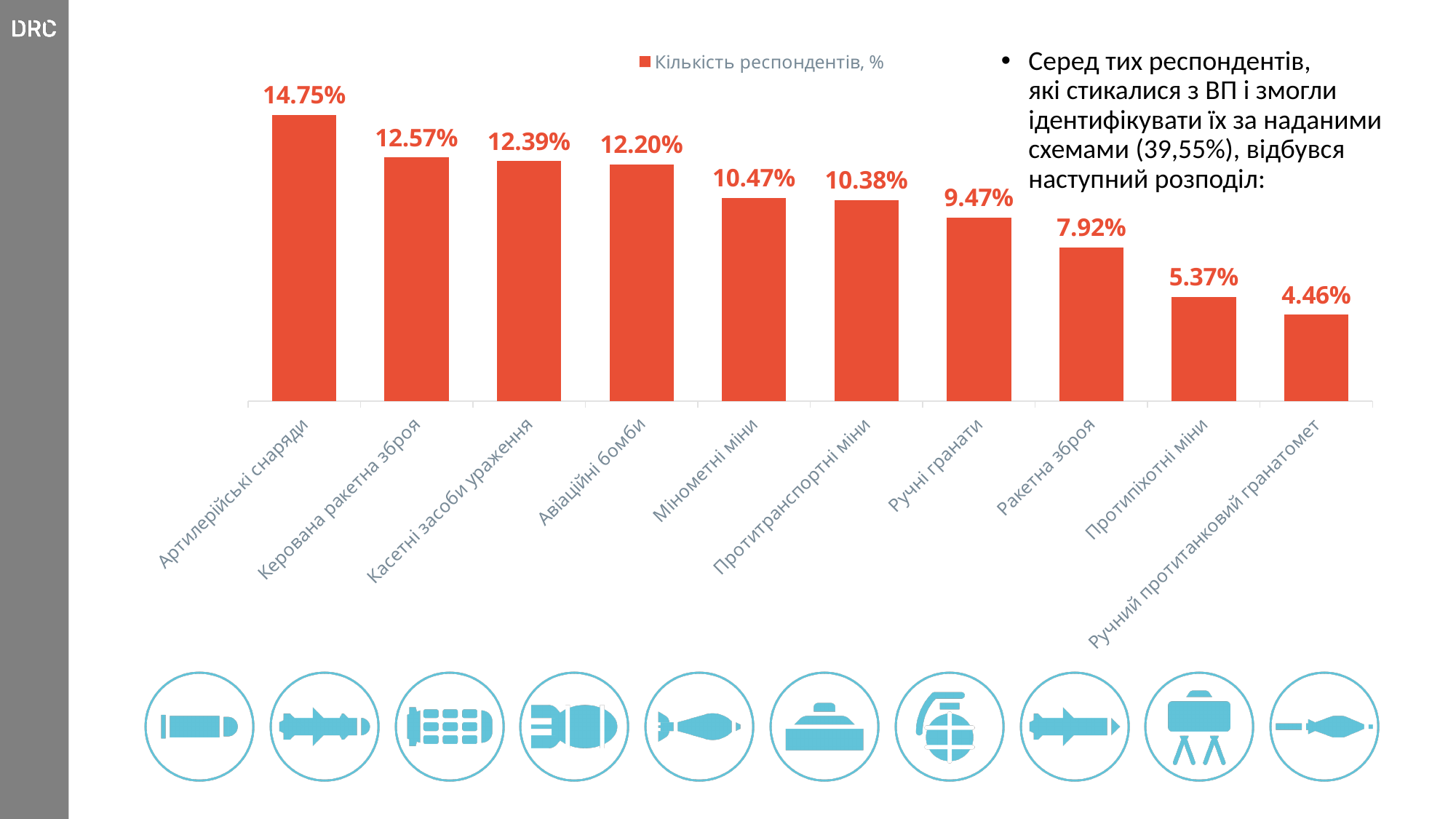
What is the value for Ручний протитанковий гранатомет? 4.46% What is the legend entry for the series in the chart? Кількість респондентів, % Which is larger, the value for Ручні гранати or the value for Протипіхотні міни? Ручні гранати What is the value for Артилерійські снаряди? 14.75% Which category has the lowest value? Ручний протитанковий гранатомет What is the difference between the values for Керована ракетна зброя and Ракетна зброя? 4.65% How many series does the legend list? 1 What kind of chart is shown on the slide? Bar chart Do the values rise or fall from left to right along the x axis? Fall How many categories are shown in the chart? 10 Which category has the highest value? Артилерійські снаряди What is the value for Мінометні міни? 10.47%